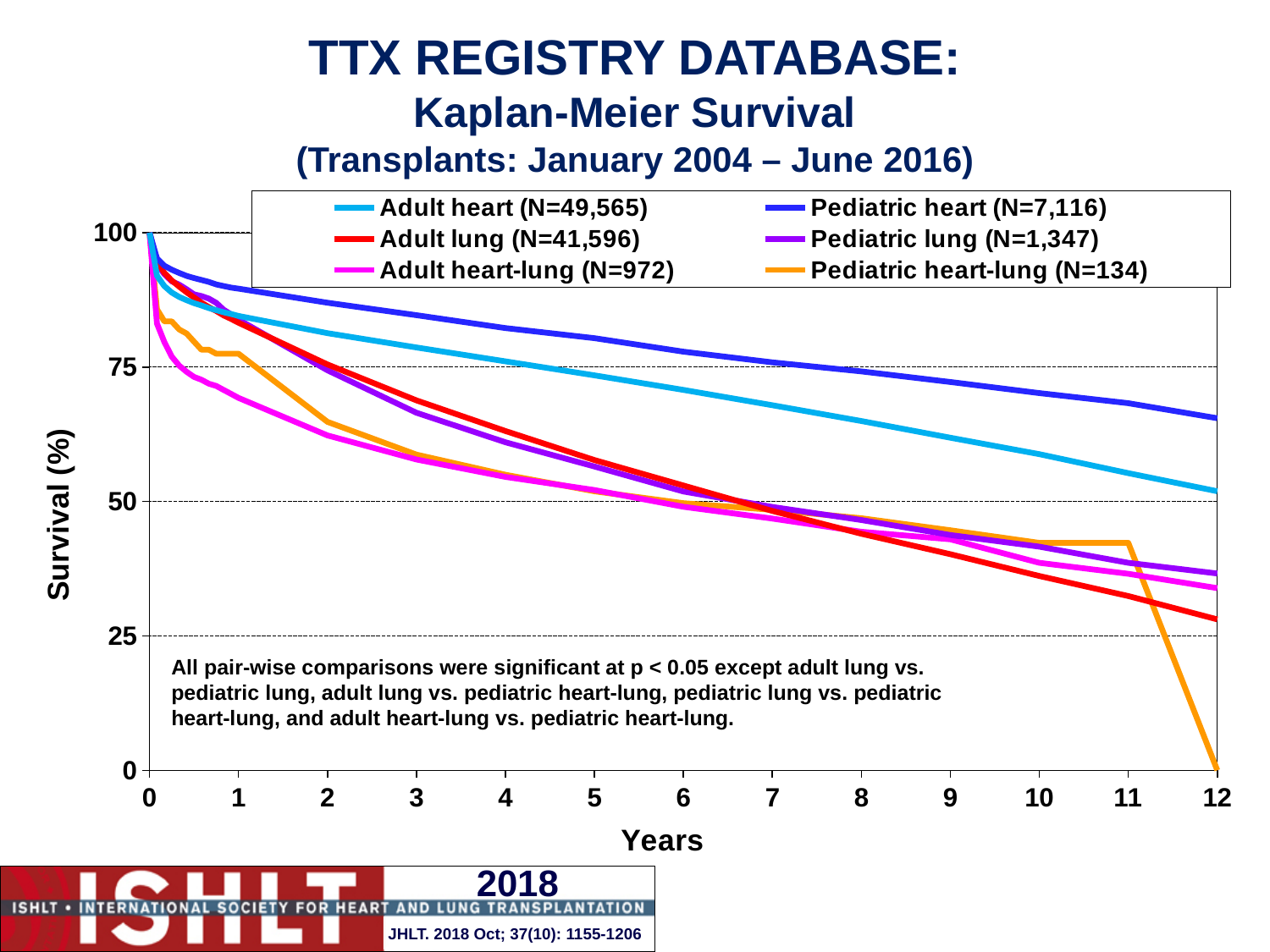
What is the N value shown in the legend for Adult heart? 49,565 Is the survival for Adult heart-lung at 12 years greater or less than 50? less Is the survival for Adult heart at 10 years greater or less than 50? greater Is the survival for Pediatric heart at 12 years greater or less than 50? greater At 12 years, which is larger: the survival for Adult heart or for Adult lung? Adult heart Do the survival curves rise or fall as years increase along the x axis? Fall What kind of chart is shown on the slide? Line chart Which series has the lowest survival at 12 years? Pediatric heart-lung (N=134) What is the label on the y axis? Survival (%) Which series has the highest survival at 12 years? Pediatric heart (N=7,116) How many series does the legend list? 6